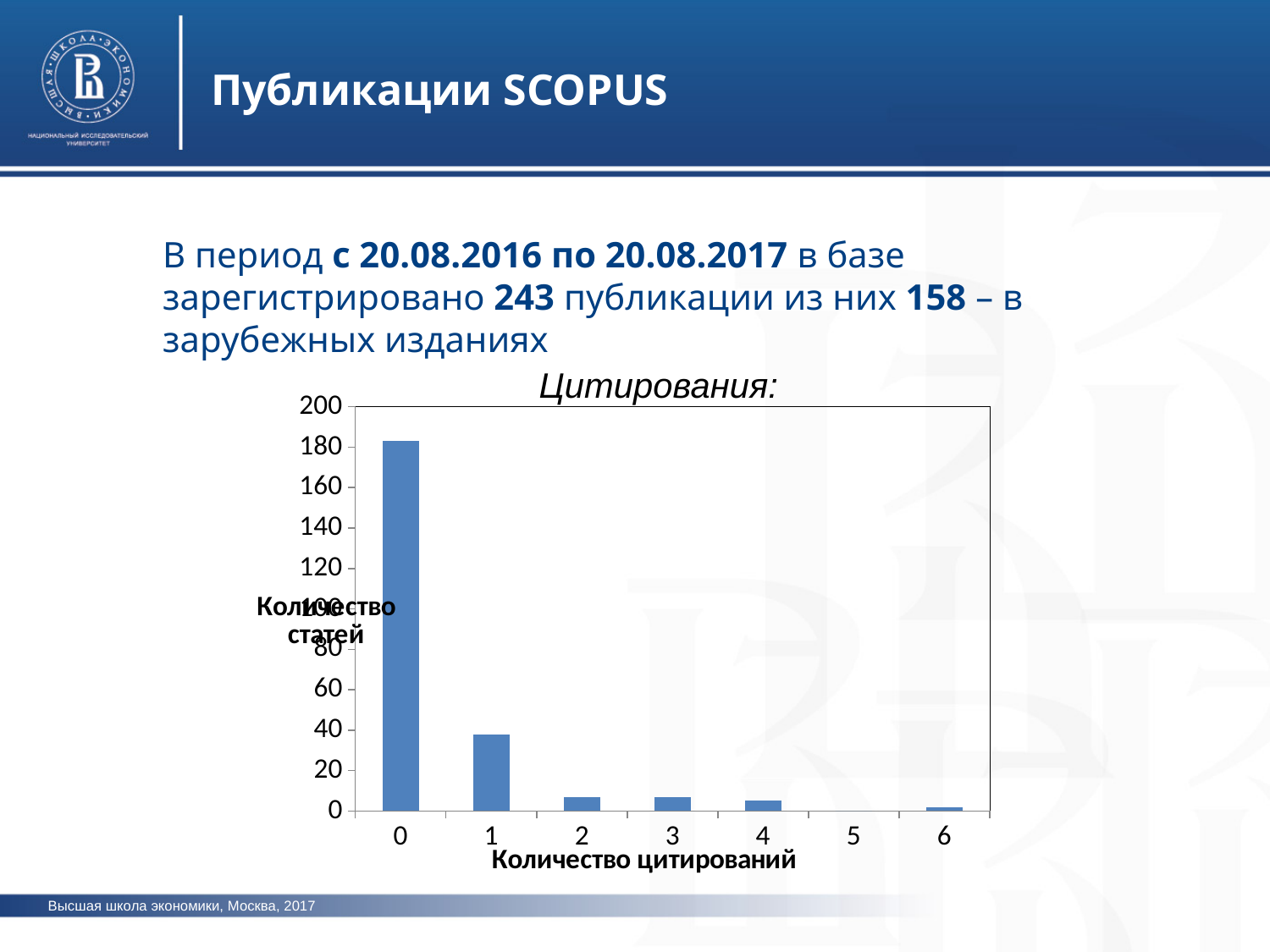
Which number of citations has the highest number of articles? 0 What is the title of the chart? Цитирования: Which number of citations has the lowest number of articles? 5 Is the number of articles with 1 citation greater or less than 20? greater Is the number of articles with 0 citations greater or less than 160? greater Do the values generally rise or fall as the number of citations increases from 0 to 6? fall What kind of chart is shown on the slide? bar chart Which has more articles: 1 citation or 4 citations? 1 citation What is the label of the x axis of the chart? Количество цитирований Is the number of articles with 2 citations greater or less than 20? less How many categories are shown on the x axis of the chart? 7